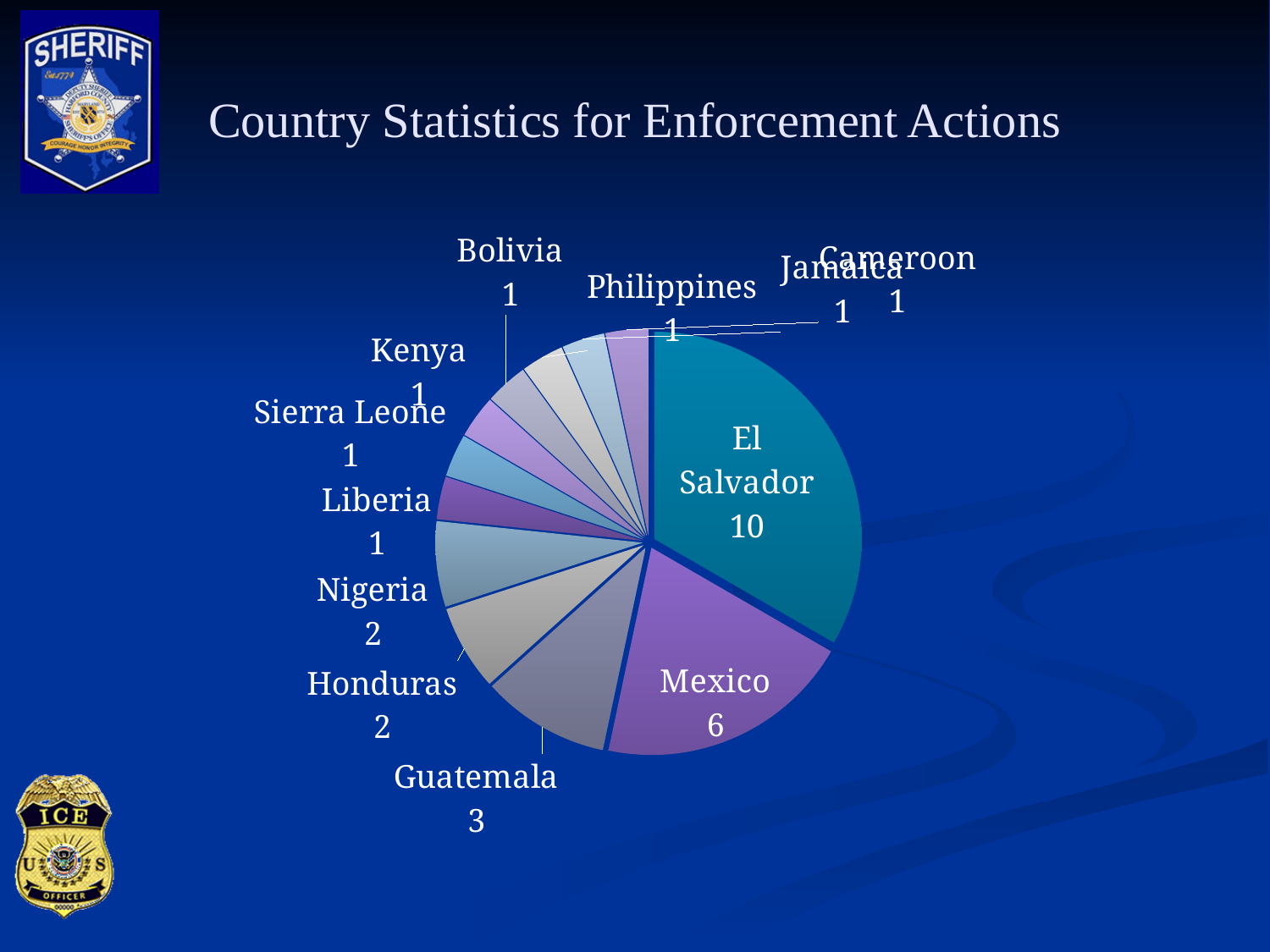
What is the title of the chart? Country Statistics for Enforcement Actions What is the value for Nigeria? 2 What is the value for Mexico? 6 What share of the pie does El Salvador represent? one third What type of chart is shown on the slide? pie chart How many enforcement actions are shown for El Salvador? 10 What is the total of all values in the pie chart? 30 What is the value for Guatemala? 3 Which country has the largest slice of the pie? El Salvador Which is larger, the value for Guatemala or the value for Honduras? Guatemala How many countries are shown in the pie chart? 12 What is the difference between the values for El Salvador and Mexico? 4